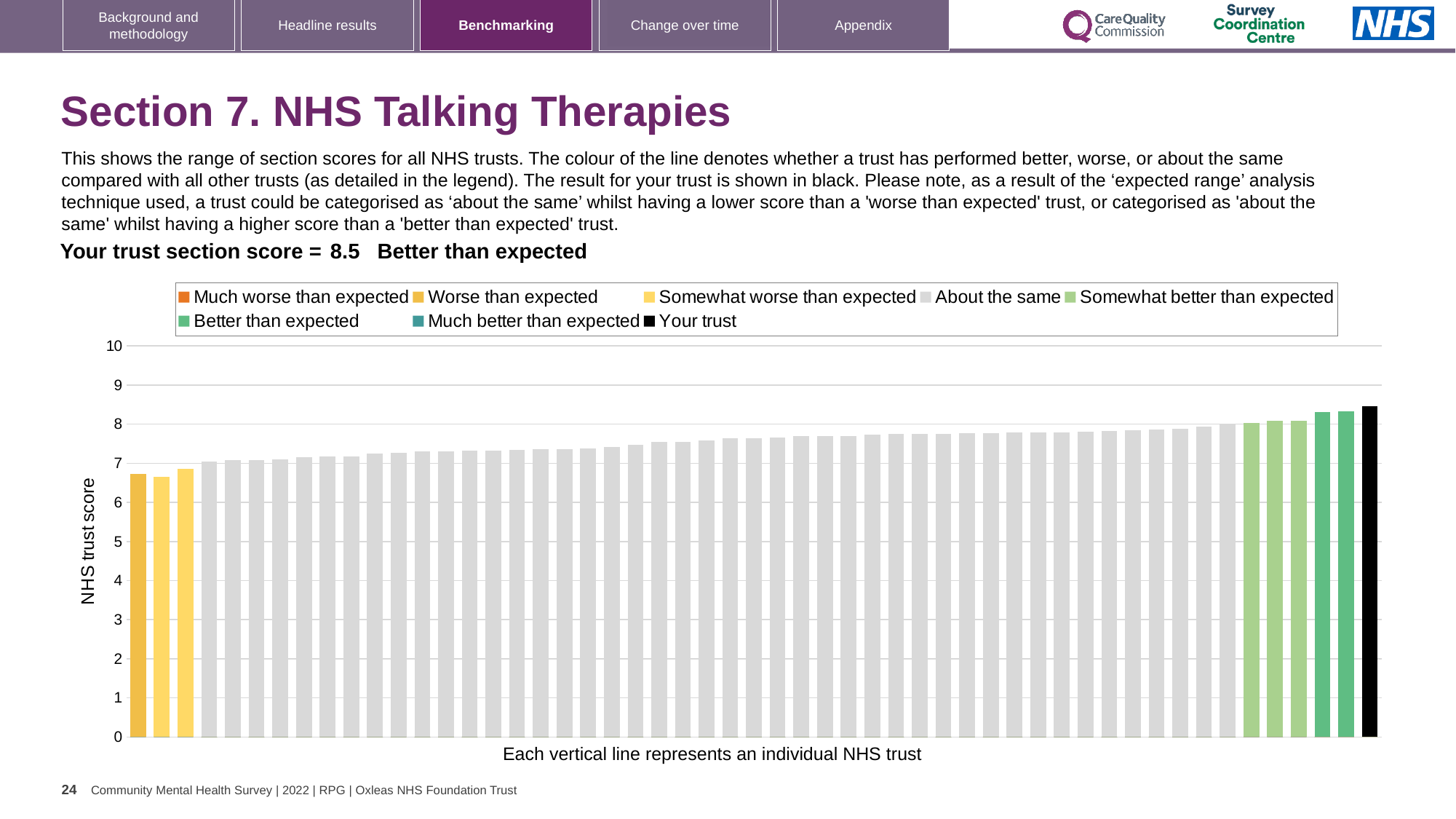
Which bar in the chart is the highest? Your trust (the black bar) According to the slide, how is your trust's section score categorised? Better than expected What kind of chart is shown on the slide? Bar chart Do the bar values rise or fall from left to right along the x axis? rise How many entries does the chart legend list? 8 What is the section score for your trust shown on the slide? 8.5 Is the value for your trust greater or less than 9? less Is the value for your trust greater or less than 8? greater Is the value of the lowest bar in the chart greater or less than 7? less What is the maximum value shown on the vertical axis of the chart? 10 What is the label on the vertical axis of the chart? NHS trust score